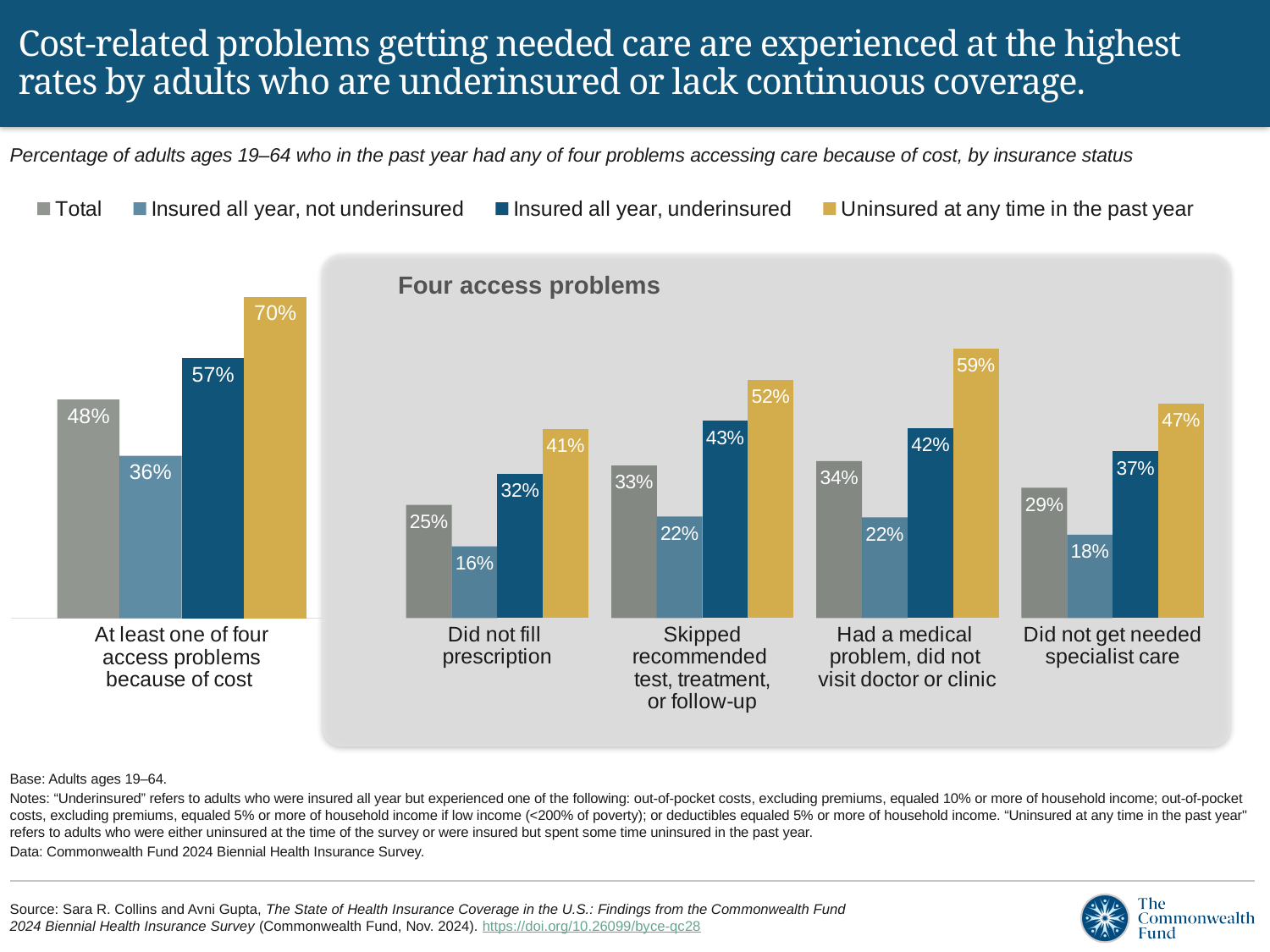
What kind of chart is shown on the slide? Bar chart Among the four access problems, which one has the highest value for adults uninsured at any time in the past year? Had a medical problem, did not visit doctor or clinic For 'Did not get needed specialist care', which is larger: the value for 'Insured all year, underinsured' or the Total value? Insured all year, underinsured What percentage of 'Insured all year, underinsured' adults skipped a recommended test, treatment, or follow-up? 43% What is the value for 'Insured all year, not underinsured' adults who did not fill a prescription? 16% Which access problem has the lowest Total value? Did not fill prescription What percentage of adults who were uninsured at any time in the past year had at least one of four access problems because of cost? 70% How many categories are shown on the x axis of the chart? 5 How many series does the legend list? 4 What is the Total value for 'Had a medical problem, did not visit doctor or clinic'? 34% What is the difference between the 'Uninsured at any time in the past year' and 'Insured all year, not underinsured' values for 'At least one of four access problems because of cost'? 34 percentage points What is the title of the shaded panel grouping the four right-hand categories? Four access problems